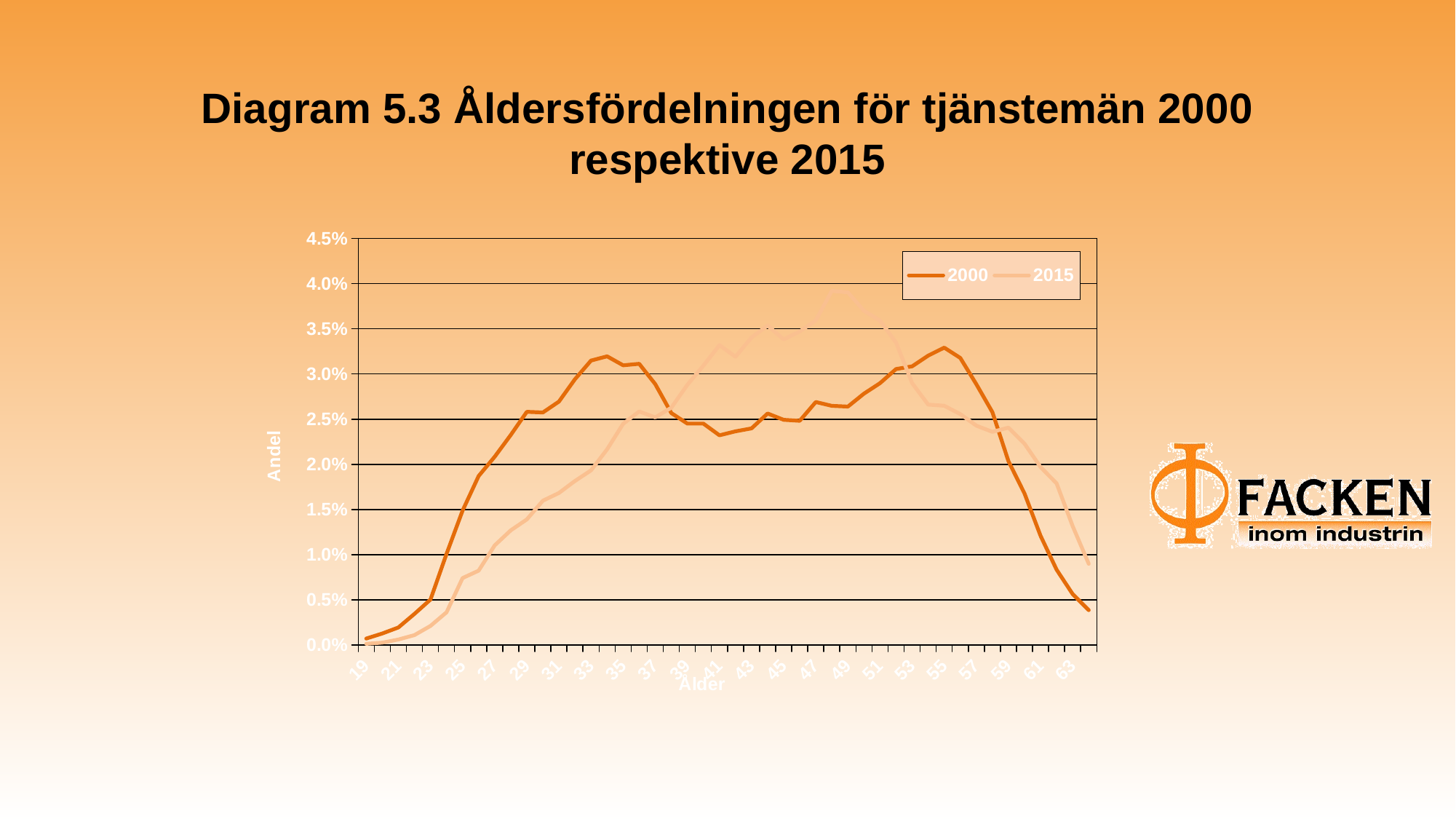
At age 49, which series has the larger value, 2000 or 2015? 2015 Which series reaches the highest value anywhere on the chart? 2015 How many series does the legend list? 2 Is the value for the 2000 series at age 55 greater or less than 3.0%? greater Does the 2000 series rise or fall between age 55 and age 63? fall At age 55, which series has the larger value, 2000 or 2015? 2000 What is the title of the vertical axis? Andel What is the title of the horizontal axis? Ålder Is the value for the 2015 series at age 49 greater or less than 3.5%? greater Is the value for the 2015 series at age 25 greater or less than 1.0%? less What kind of chart is shown on the slide? line chart